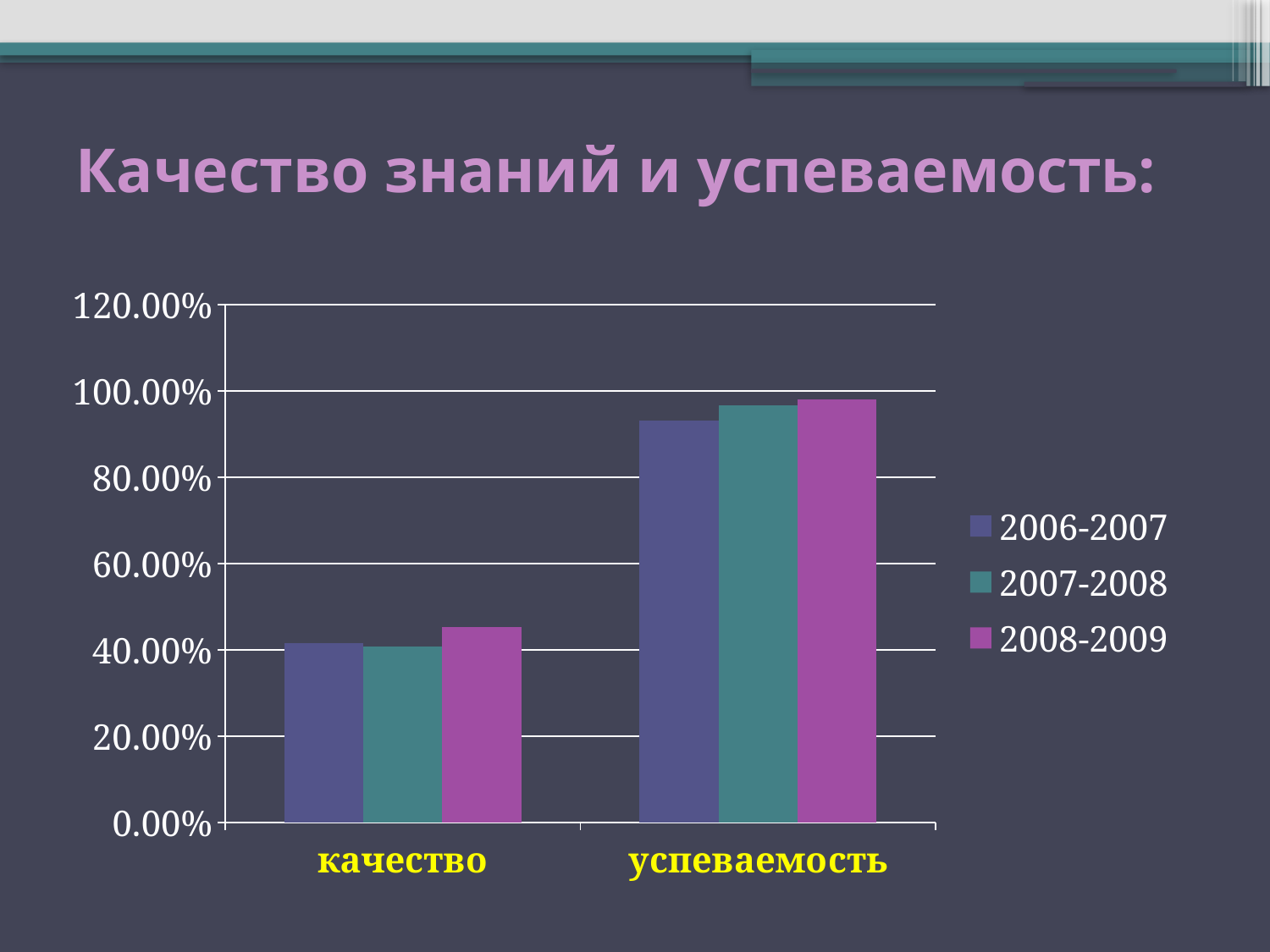
Which series has the lowest value in the успеваемость category? 2006-2007 What is the title of the slide? Качество знаний и успеваемость: How many series does the legend list? 3 Which series is shown in purple in the legend? 2008-2009 Is the value for 2006-2007 in the качество category greater or less than 60.00%? less What kind of chart is shown on the slide? bar chart Is the value for 2008-2009 in the качество category greater or less than 40.00%? greater How many categories are shown on the x axis of the chart? 2 Is the value for 2008-2009 in the успеваемость category greater or less than 80.00%? greater In the качество category, which is larger: the value for 2007-2008 or the value for 2008-2009? 2008-2009 Which series has the highest value in the качество category? 2008-2009